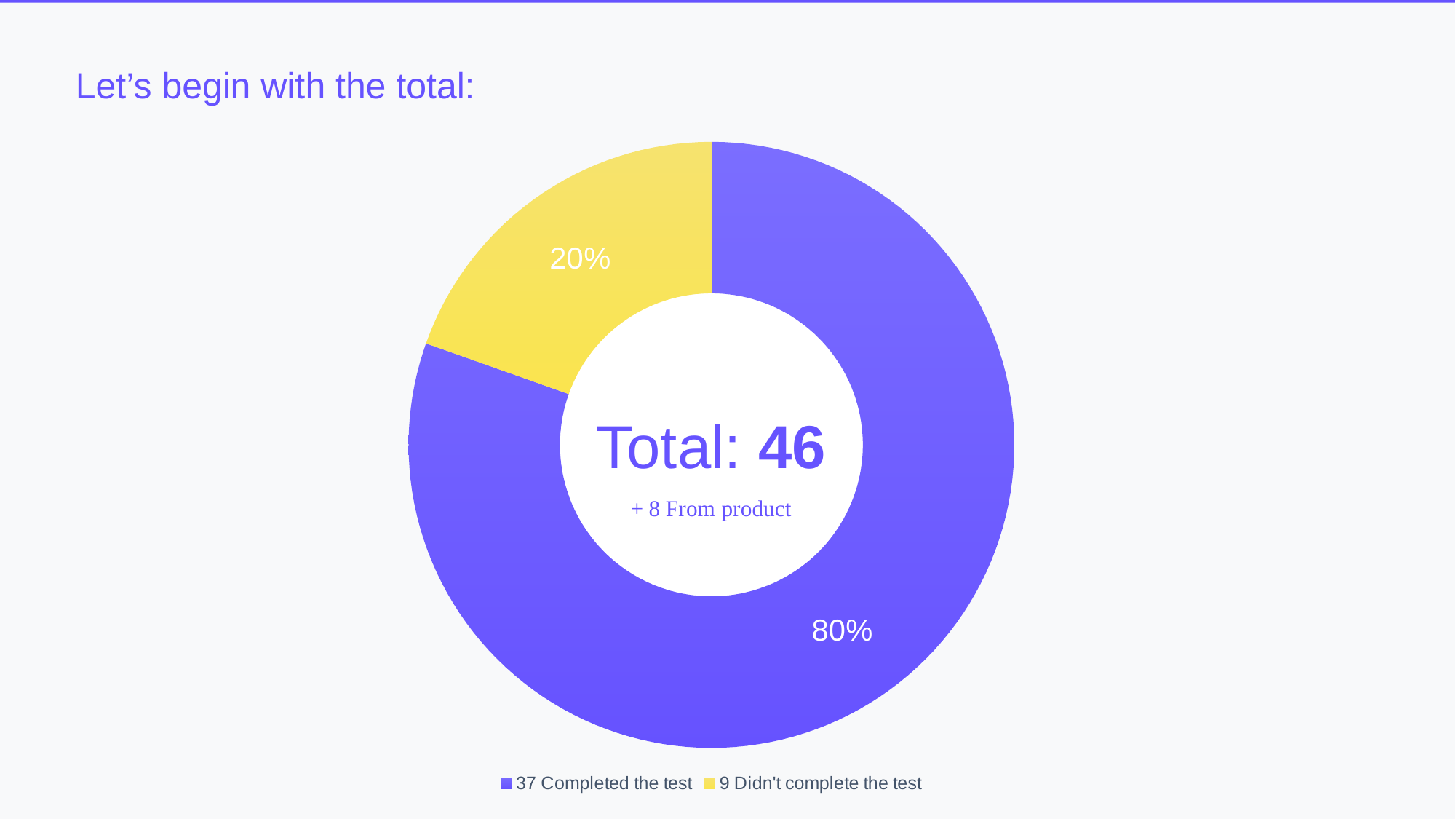
What is the difference in percentage points between the 'Completed the test' slice and the 'Didn't complete the test' slice? 60 percentage points How many entries does the legend list? 2 Which slice is the smallest in the pie chart? Didn't complete the test What percentage of the pie is labelled for the 'Didn't complete the test' slice? 20% What total is printed in the centre of the chart? 46 According to the legend, how many people completed the test? 37 What colour is the 'Didn't complete the test' slice? Yellow According to the legend, how many people didn't complete the test? 9 What kind of chart is shown on the slide? Pie chart (doughnut) Which slice is the largest in the pie chart? Completed the test How many slices does the pie chart have? 2 What percentage of the pie is labelled for the 'Completed the test' slice? 80%